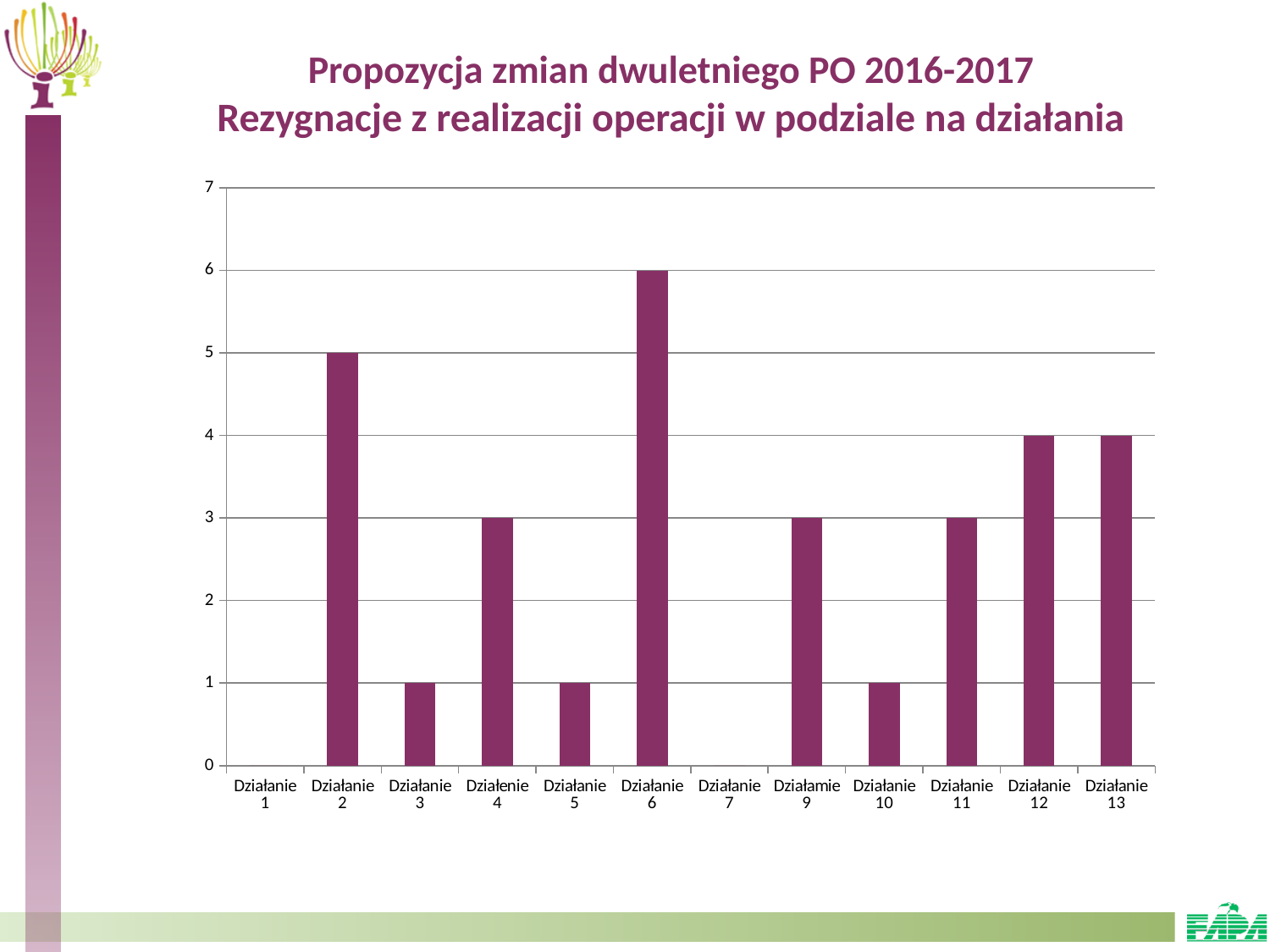
How many categories are shown on the x axis? 12 What is the value for Działanie 2? 5 What is the value for Działanie 10? 1 What is the difference between the values for Działanie 12 and Działanie 3? 3 What kind of chart is shown on the slide? bar chart What is the value for Działanie 6? 6 What is the maximum value shown on the vertical axis? 7 Which category has the highest value? Działanie 6 What is the difference between the values for Działanie 6 and Działanie 2? 1 Is the value for Działanie 6 greater or less than 5? greater What is the value for Działanie 12? 4 Which is larger, the value for Działanie 11 or the value for Działanie 5? Działanie 11